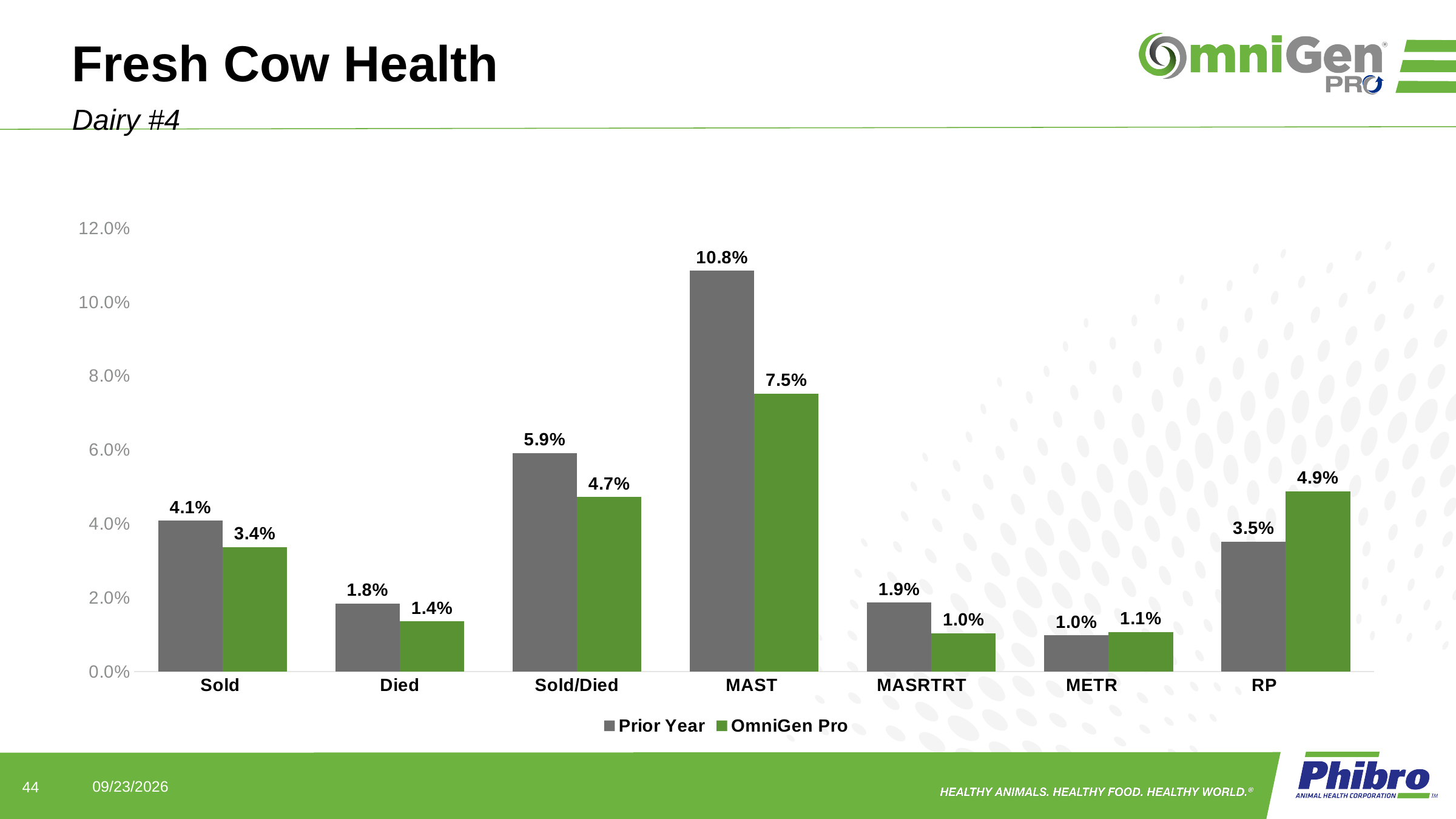
What colour are the OmniGen Pro bars? Green What is the difference between the Prior Year and OmniGen Pro values for MAST? 3.3% For RP, which series has the larger value, Prior Year or OmniGen Pro? OmniGen Pro What is the Prior Year value for MAST? 10.8% Which category has the lowest OmniGen Pro value? MASRTRT What is the OmniGen Pro value for RP? 4.9% What kind of chart is shown on the slide? Bar chart What is the OmniGen Pro value for Sold/Died? 4.7% Which category has the highest Prior Year value? MAST How many categories are shown on the x axis? 7 How many series does the legend list? 2 Is the Prior Year value for Sold/Died greater or less than 4.0%? greater